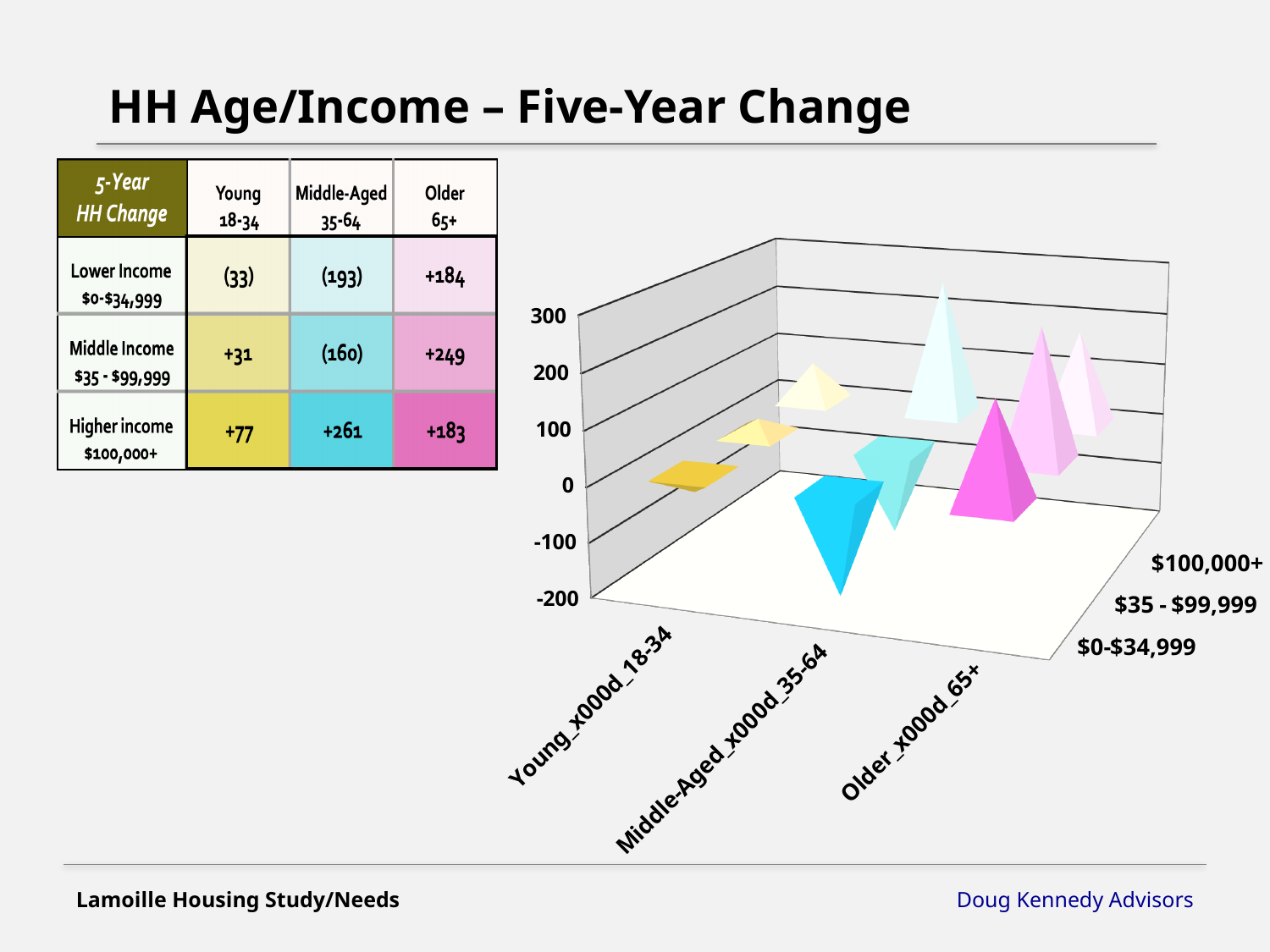
Is the value for Middle-Aged 35-64 in the $0-$34,999 income group greater or less than 0? less What is the lowest value shown on the chart's vertical axis? -200 What kind of chart is shown on the slide? 3D bar chart According to the table on the slide, which age group has the lowest five-year change in the middle income ($35-$99,999) group? Middle-Aged 35-64 According to the table on the slide, what is the five-year change for Middle-Aged 35-64 households with higher income ($100,000+)? +261 What is the highest value shown on the chart's vertical axis? 300 How many income groups are shown along the depth axis of the chart? 3 Is the value for Older 65+ in the $0-$34,999 income group greater or less than 0? greater According to the table on the slide, which age group has the largest five-year change in the lower income ($0-$34,999) group? Older 65+ Is the value for Middle-Aged 35-64 in the $100,000+ income group greater or less than 100? greater How many age categories are shown along the front axis of the chart? 3 According to the table on the slide, what is the five-year change for Older 65+ households with middle income ($35-$99,999)? +249